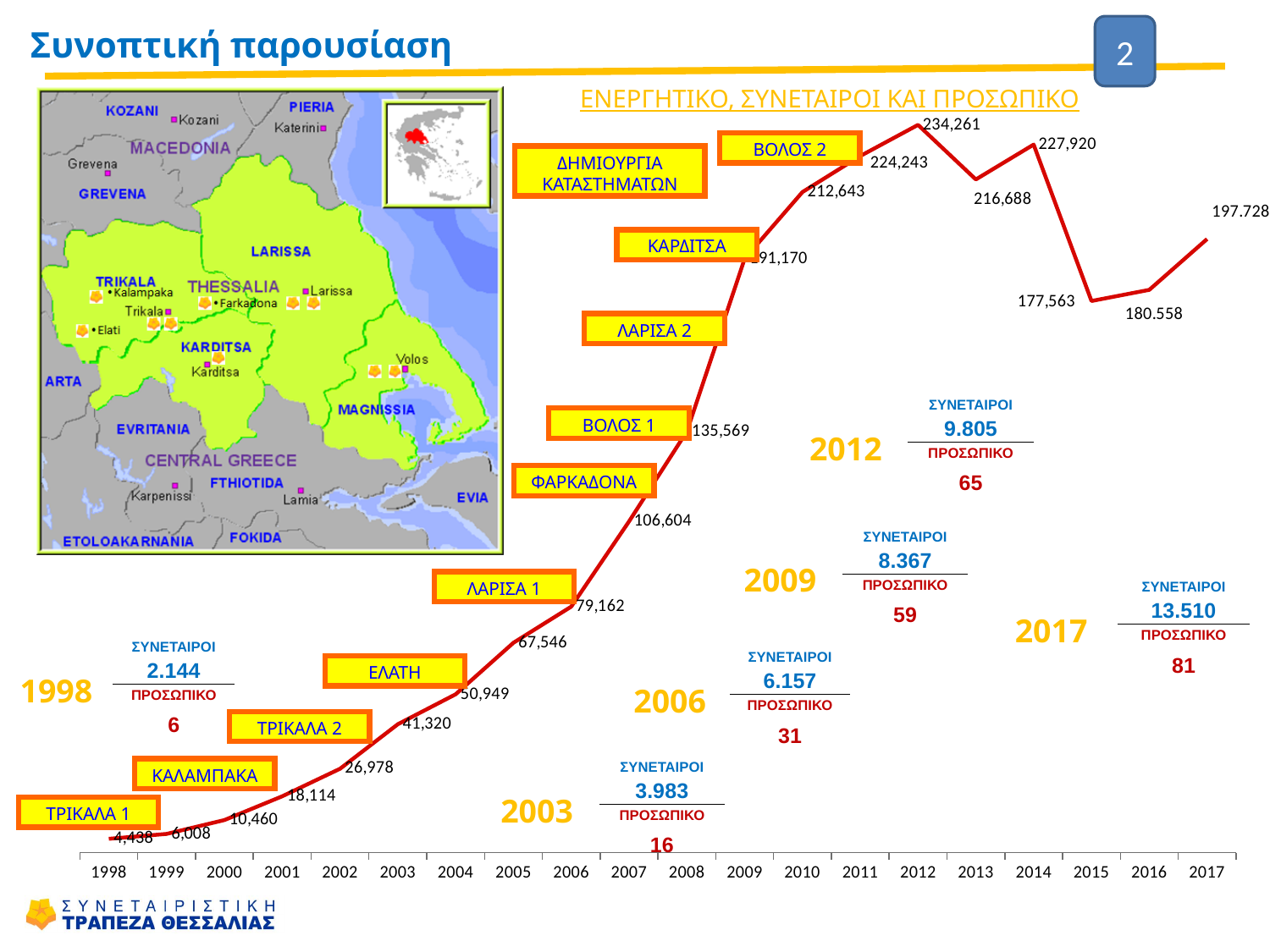
What is the value plotted for 2017? 197.728 In which year does the line reach its highest value? 2012 What is the value plotted for 2012? 234,261 What is the difference between the values for 2012 and 2013? 17,573 Which year has the larger value, 2014 or 2015? 2014 How many years are shown on the x axis of the chart? 20 What is the title of the chart? ΕΝΕΡΓΗΤΙΚΟ, ΣΥΝΕΤΑΙΡΟΙ ΚΑΙ ΠΡΟΣΩΠΙΚΟ What type of chart is shown on the slide? line chart What is the value plotted for 1998? 4,438 What is the value plotted for 2008? 135,569 What is the difference between the values for 2011 and 2010? 11,600 In which year does the line have its lowest value? 1998